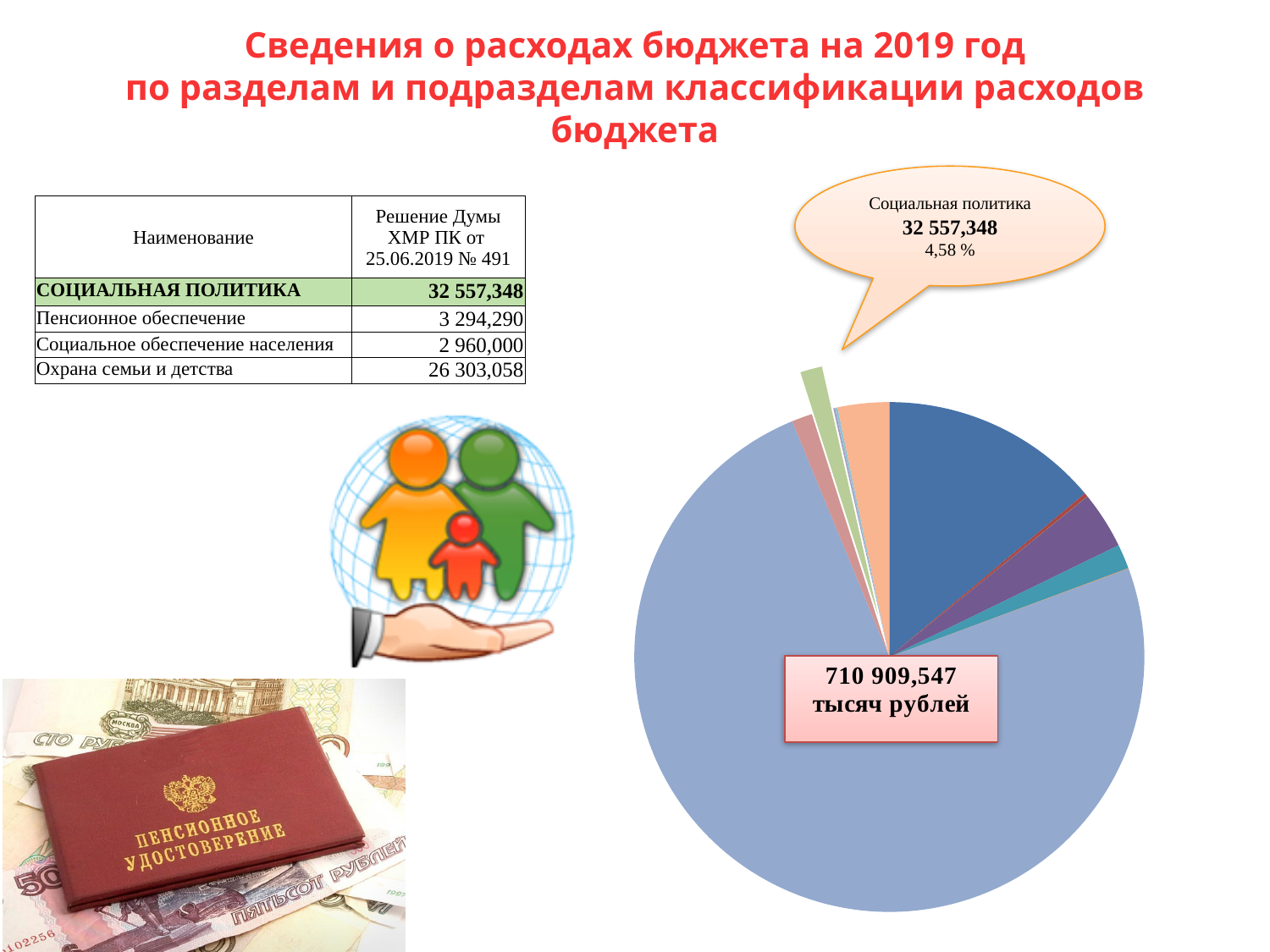
What kind of chart is shown on the right side of the slide? pie chart What total amount is shown in the box on the pie chart? 710 909,547 тысяч рублей Is the share of Социальная политика in the pie chart greater or less than 5%? less In the pie chart, what value is shown in the callout for Социальная политика? 32 557,348 Which slice of the pie chart is pulled out from the rest of the pie? Социальная политика Does the Социальная политика slice make up more or less than half of the pie chart? less In the pie chart, what share of the total does Социальная политика represent according to the callout? 4,58 % What colour is the pulled-out Социальная политика slice in the pie chart? light green